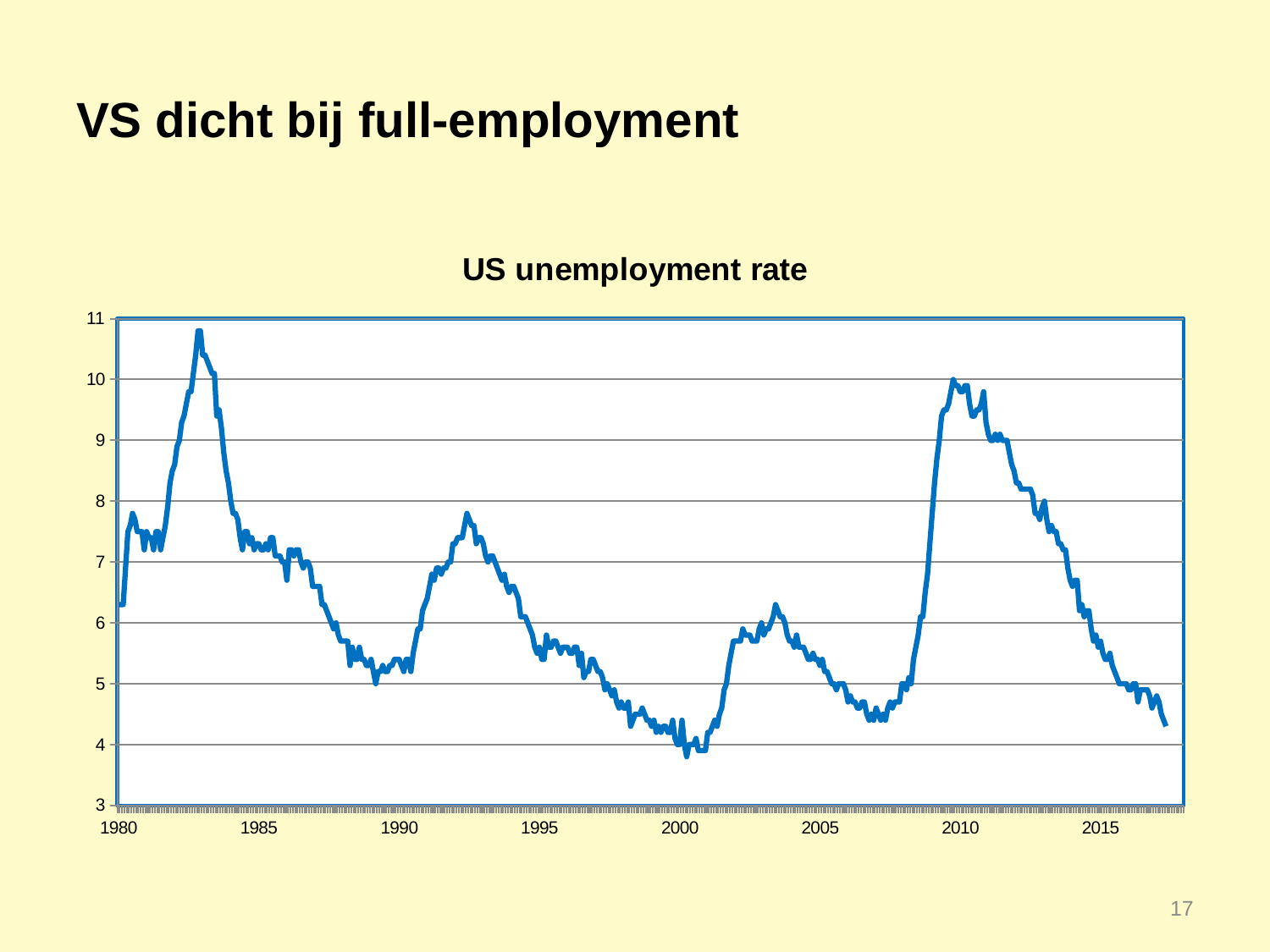
Around which year does the US unemployment rate reach its lowest point in the chart? 2000 Does the US unemployment rate rise or fall between 2010 and the end of the series? fall Is the US unemployment rate at the start of 2010 greater or less than 9? greater Around which year does the US unemployment rate reach its highest point in the chart? 1983 How many lines (series) are plotted in the chart? 1 Is the peak of the US unemployment rate around 1983 greater or less than 10? greater What is the title of the chart? US unemployment rate Is the US unemployment rate at the start of 2000 greater or less than 5? less What kind of chart is shown on the slide? line chart What is the highest value shown on the vertical axis of the chart? 11 Is the US unemployment rate higher at its peak around 1983 or at its peak around 2010? 1983